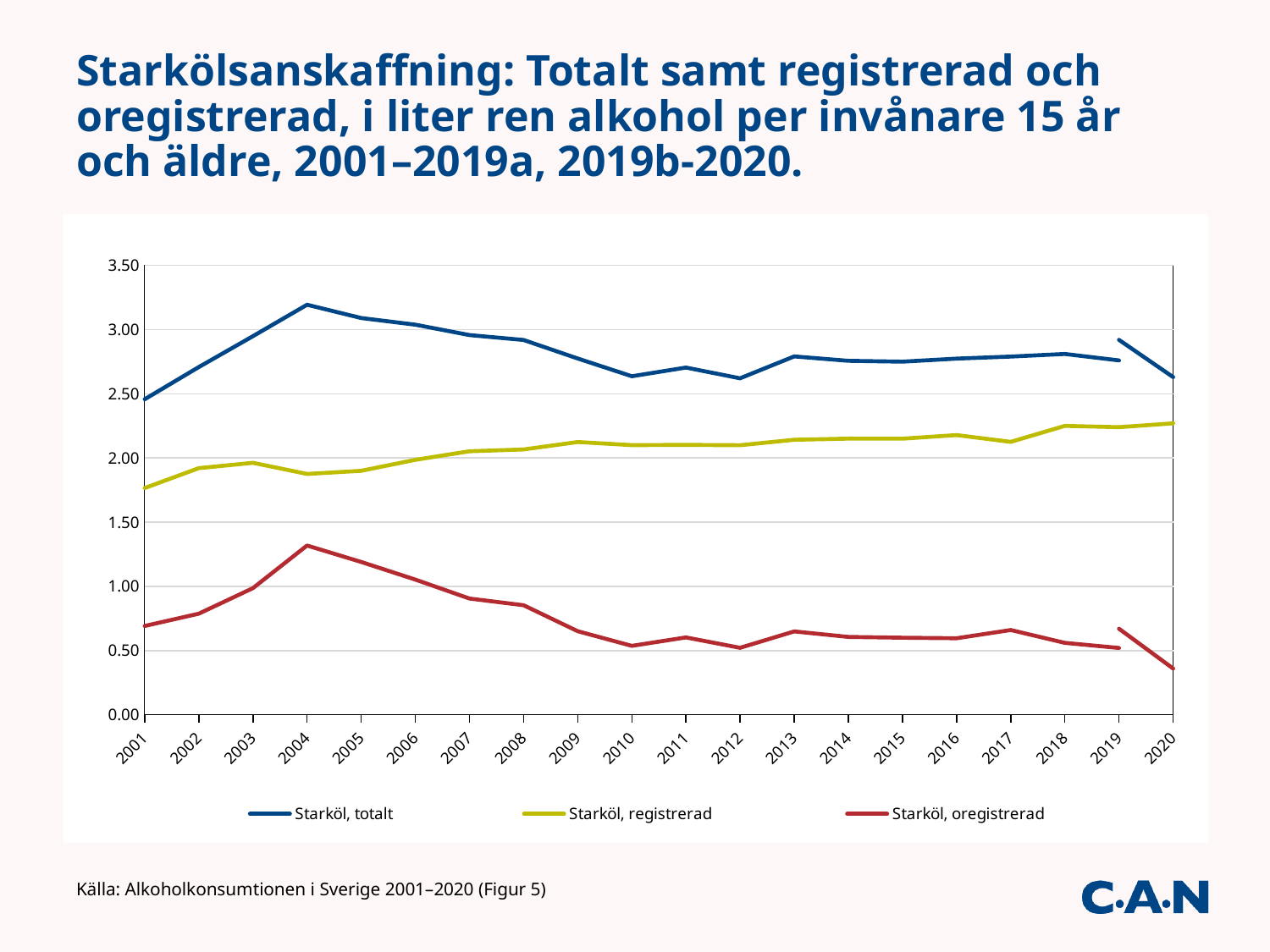
In 2004, which is larger: Starköl, registrerad or Starköl, oregistrerad? Starköl, registrerad Does the value for Starköl, oregistrerad rise or fall from 2004 to 2010? fall Is the value for Starköl, registrerad in 2001 greater or less than 2.00? less In which year is the value for Starköl, totalt highest? 2004 How many years are shown along the x axis? 20 How many series does the legend list? 3 In which year is the value for Starköl, oregistrerad highest? 2004 In which year is the value for Starköl, oregistrerad lowest? 2020 What kind of chart is shown on the slide? line chart What colour is the line for Starköl, totalt? blue Is the value for Starköl, totalt in 2004 greater or less than 3.00? greater Is the value for Starköl, oregistrerad in 2010 greater or less than 1.00? less